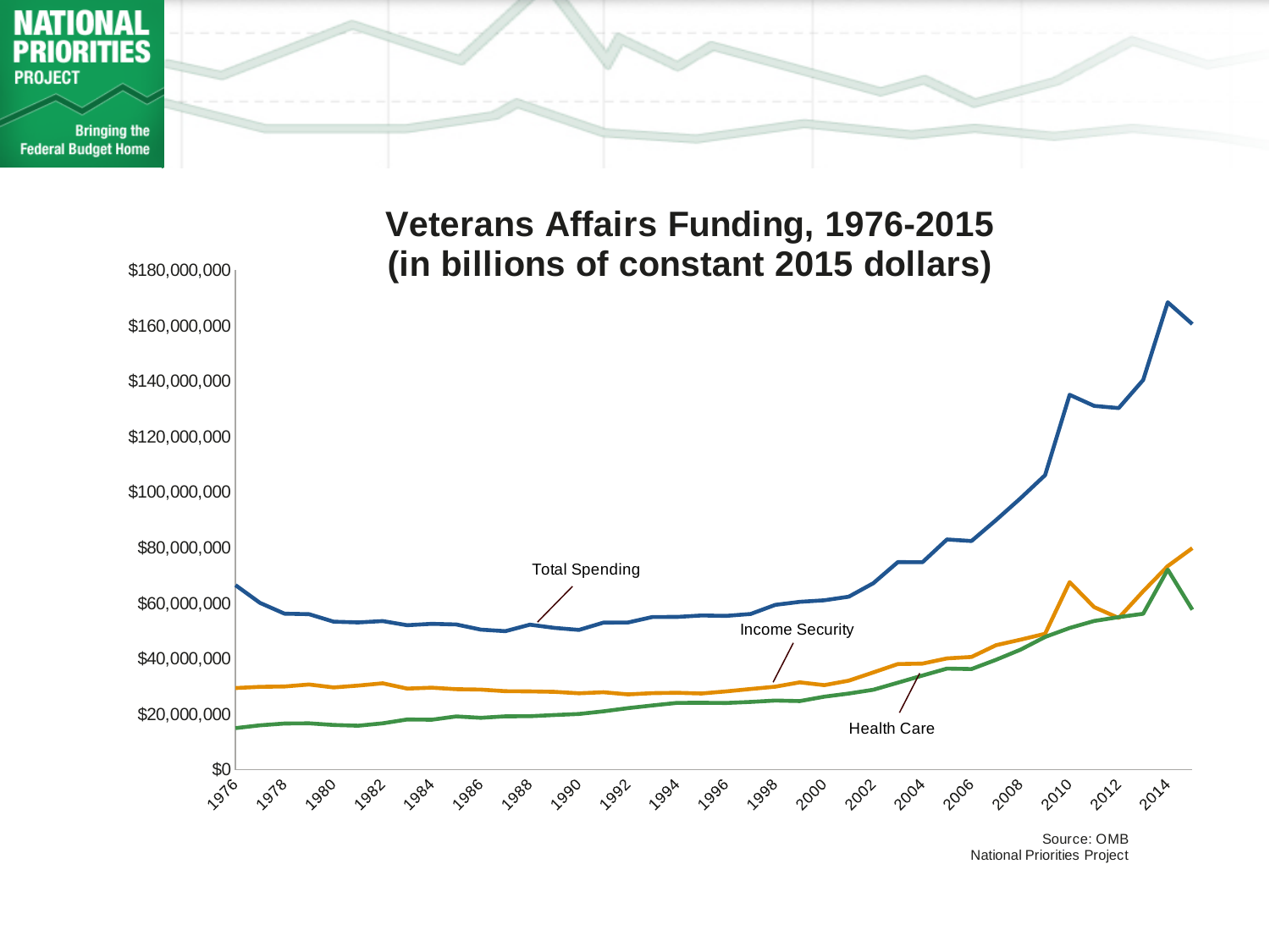
Is the value for Total Spending in 1976 greater or less than $60,000,000? greater Does Total Spending rise or fall between 2002 and 2014? Rise What is the title of the chart? Veterans Affairs Funding, 1976-2015 (in billions of constant 2015 dollars) What kind of chart is shown on the slide? Line chart Which series has the highest values throughout the chart? Total Spending Which series has the lowest value in 1976? Health Care Is the value for Total Spending in 2010 greater or less than $120,000,000? greater Is the value for Total Spending in 2014 greater or less than $160,000,000? greater How many series are plotted on the chart? 3 In 1976, which is larger: Income Security or Health Care? Income Security